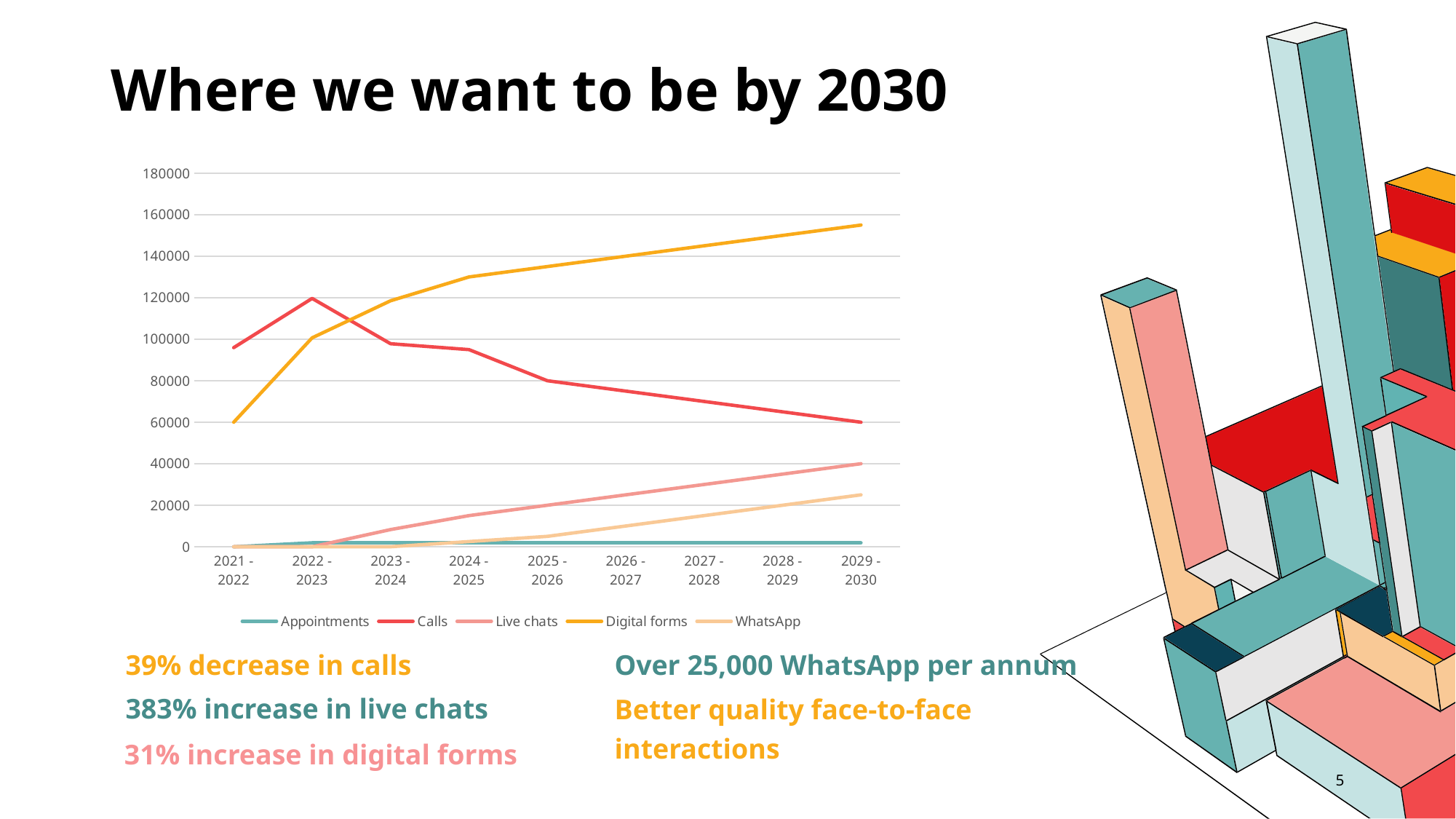
How many year periods are shown along the x axis of the chart? 9 Does the Calls line rise or fall from 2022 - 2023 to 2029 - 2030? fall In 2021 - 2022, which is larger: Calls or Digital forms? Calls What kind of chart is shown on the slide? line chart Does the Digital forms line rise or fall across the years shown? rise Which series has the highest value in 2029 - 2030? Digital forms Which series has the highest value in 2021 - 2022? Calls Is the value for Calls in 2025 - 2026 greater or less than 100000? less Which series has the lowest value in 2029 - 2030? Appointments How many series does the chart legend list? 5 Is the value for Digital forms in 2029 - 2030 greater or less than 140000? greater In 2029 - 2030, which is larger: Live chats or WhatsApp? Live chats